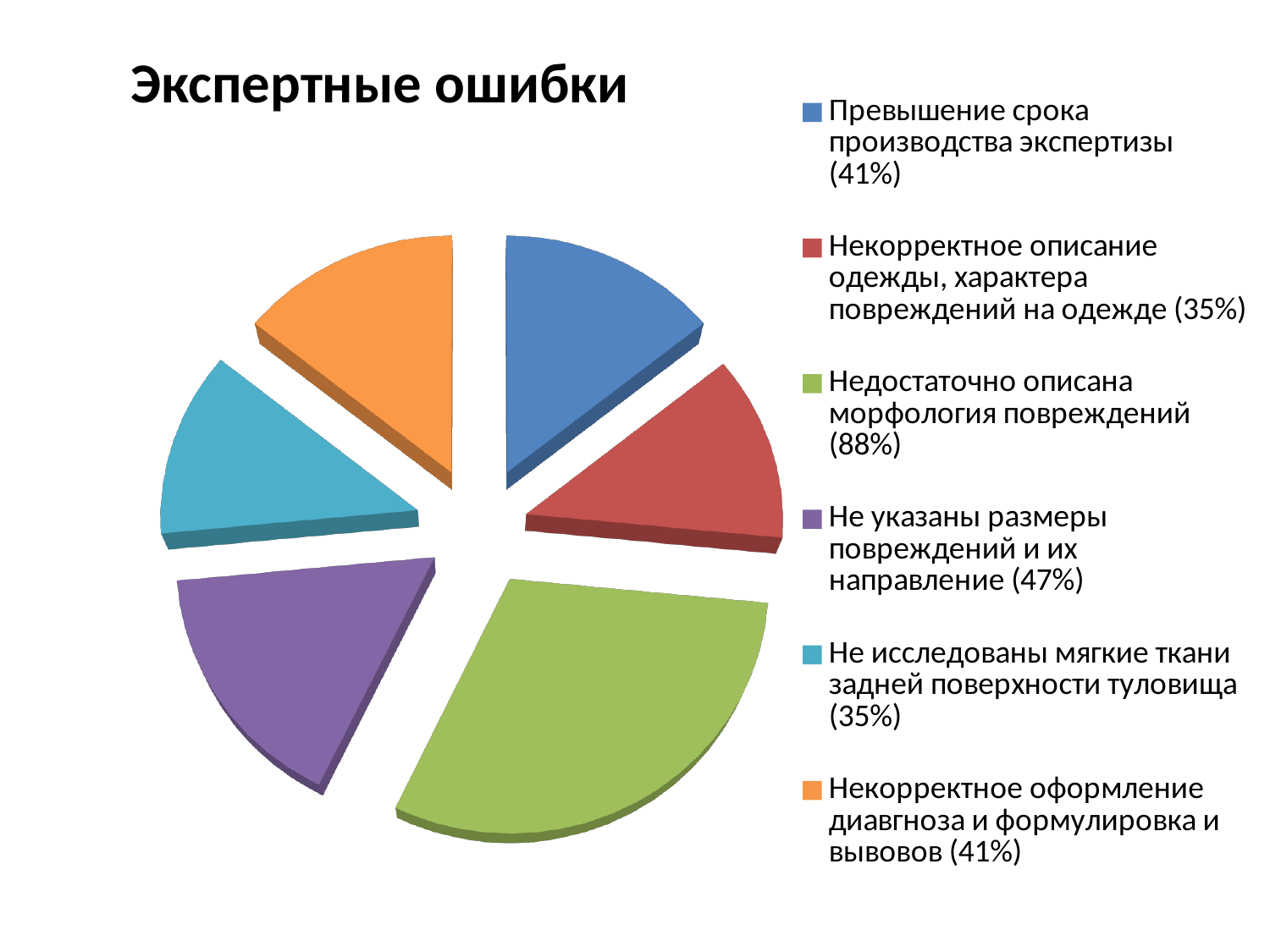
What value is given for "Превышение срока производства экспертизы"? 41% What value is given for "Не указаны размеры повреждений и их направление"? 47% What is the difference between the values for "Недостаточно описана морфология повреждений" (88%) and "Не указаны размеры повреждений и их направление" (47%)? 41% What is the difference between the values for "Не указаны размеры повреждений и их направление" (47%) and "Некорректное описание одежды, характера повреждений на одежде" (35%)? 12% Which category has the largest slice of the pie? Недостаточно описана морфология повреждений What value is given for "Недостаточно описана морфология повреждений"? 88% What colour is the slice for "Некорректное оформление диавгноза и формулировка и вывовов"? orange What value is given for "Не исследованы мягкие ткани задней поверхности туловища"? 35% What is the title of the chart? Экспертные ошибки Which is larger: the value for "Недостаточно описана морфология повреждений" or for "Превышение срока производства экспертизы"? Недостаточно описана морфология повреждений How many categories does the pie chart have? 6 What kind of chart is shown on the slide? pie chart